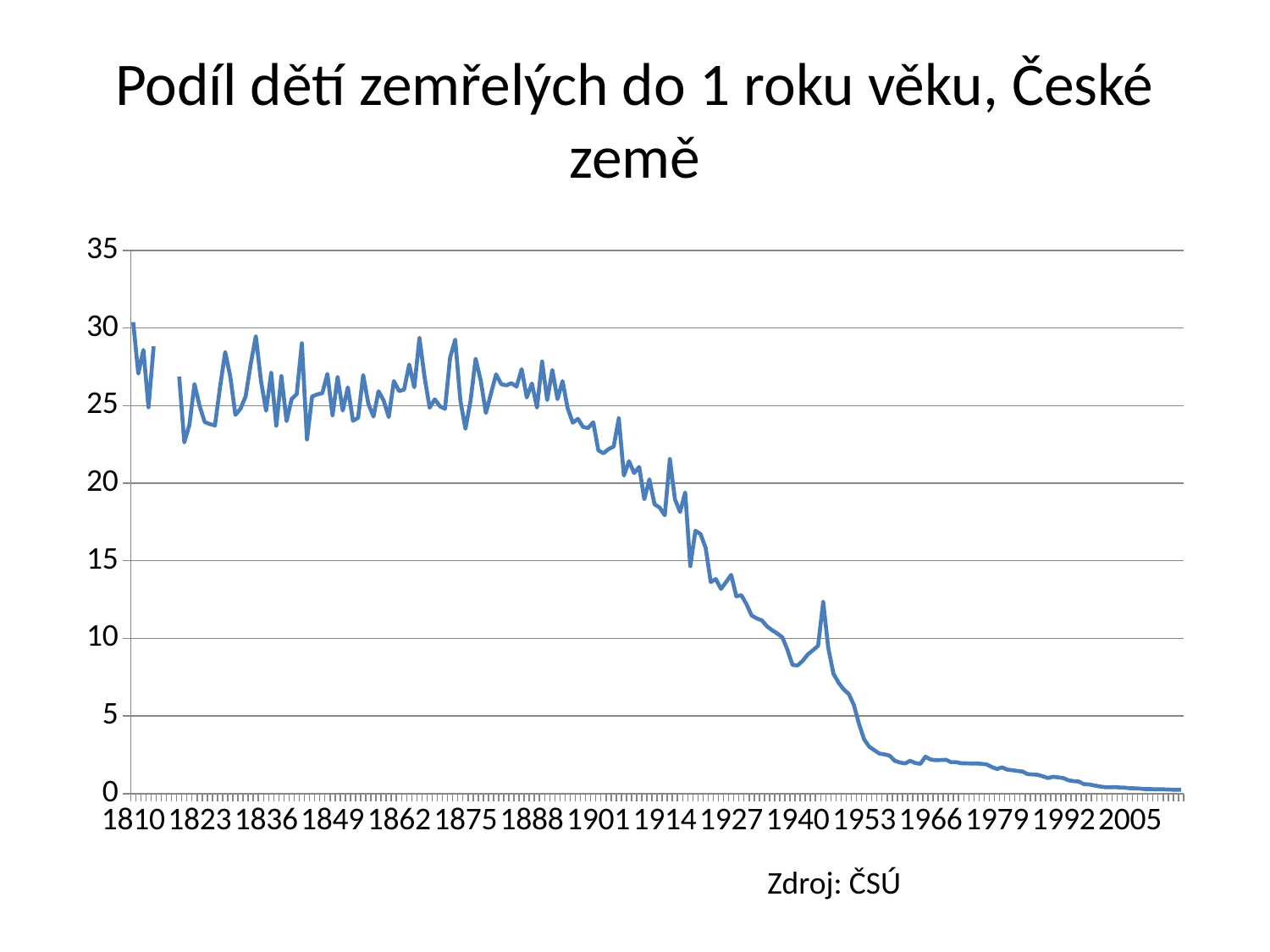
Is the value for 1953 greater or less than 10? less What kind of chart is shown on the slide? line chart Are the lowest values on the chart found at the beginning or at the end of the period? at the end Is the value for 2005 greater or less than 5? less Is the value for 1901 greater or less than 20? greater Overall, do the values rise or fall from 1810 to the end of the period? fall Which is larger, the value for 1862 or the value for 1927? 1862 What source is cited below the chart? ČSÚ What is the title of the chart? Podíl dětí zemřelých do 1 roku věku, České země